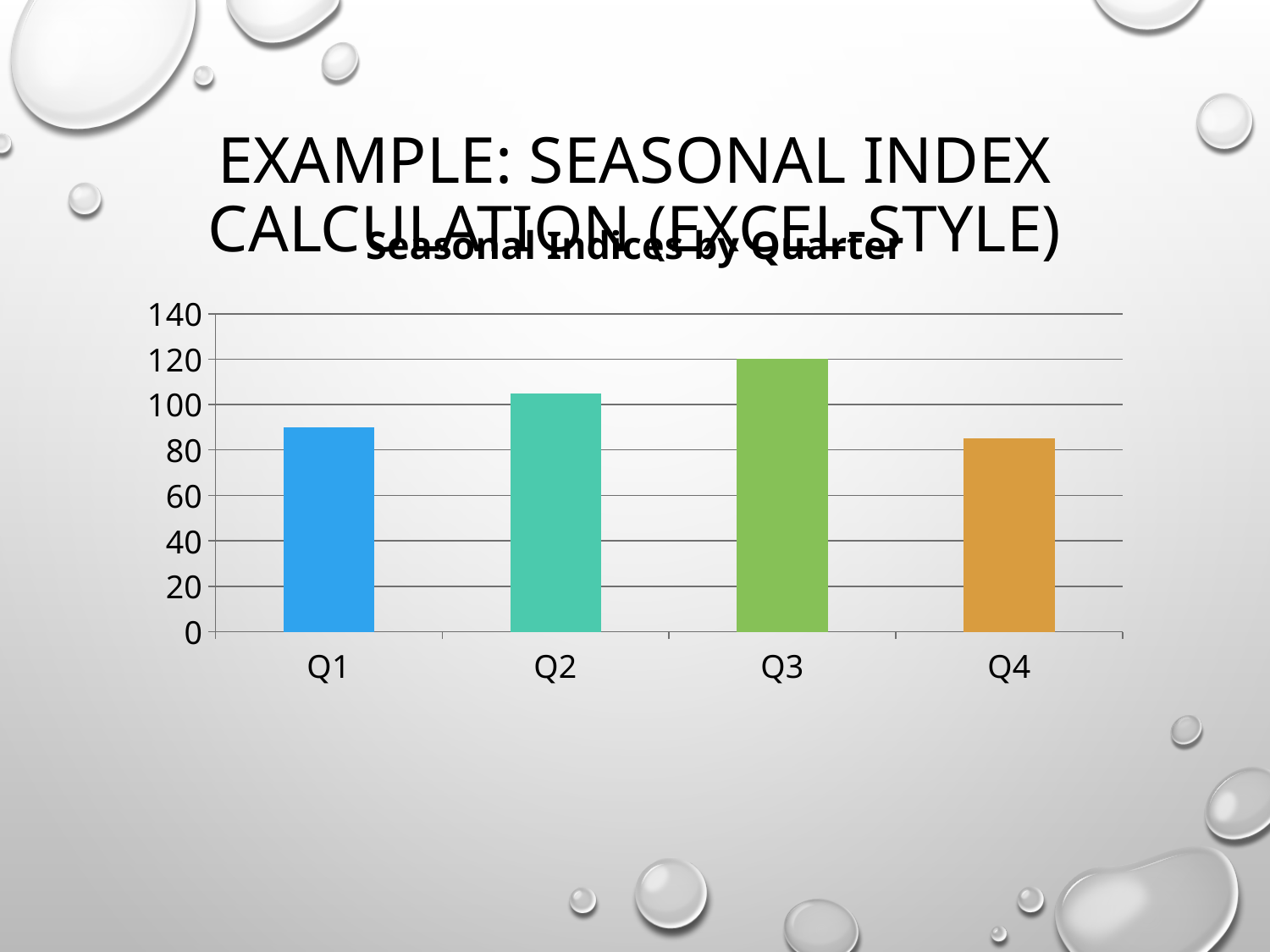
Is the value for Q4 greater or less than 80? greater What is the value for Q3? 120 Which is larger, the value for Q1 or the value for Q4? Q1 What kind of chart is shown on the slide? bar chart Which is larger, the value for Q1 or the value for Q2? Q2 Which quarter has the lowest seasonal index? Q4 Is the value for Q2 greater or less than 100? greater How many quarters are plotted on the x axis? 4 Do the values rise or fall from Q3 to Q4? fall Is the value for Q1 greater or less than 100? less Which quarter has the highest seasonal index? Q3 What is the title of the chart? Seasonal Indices by Quarter